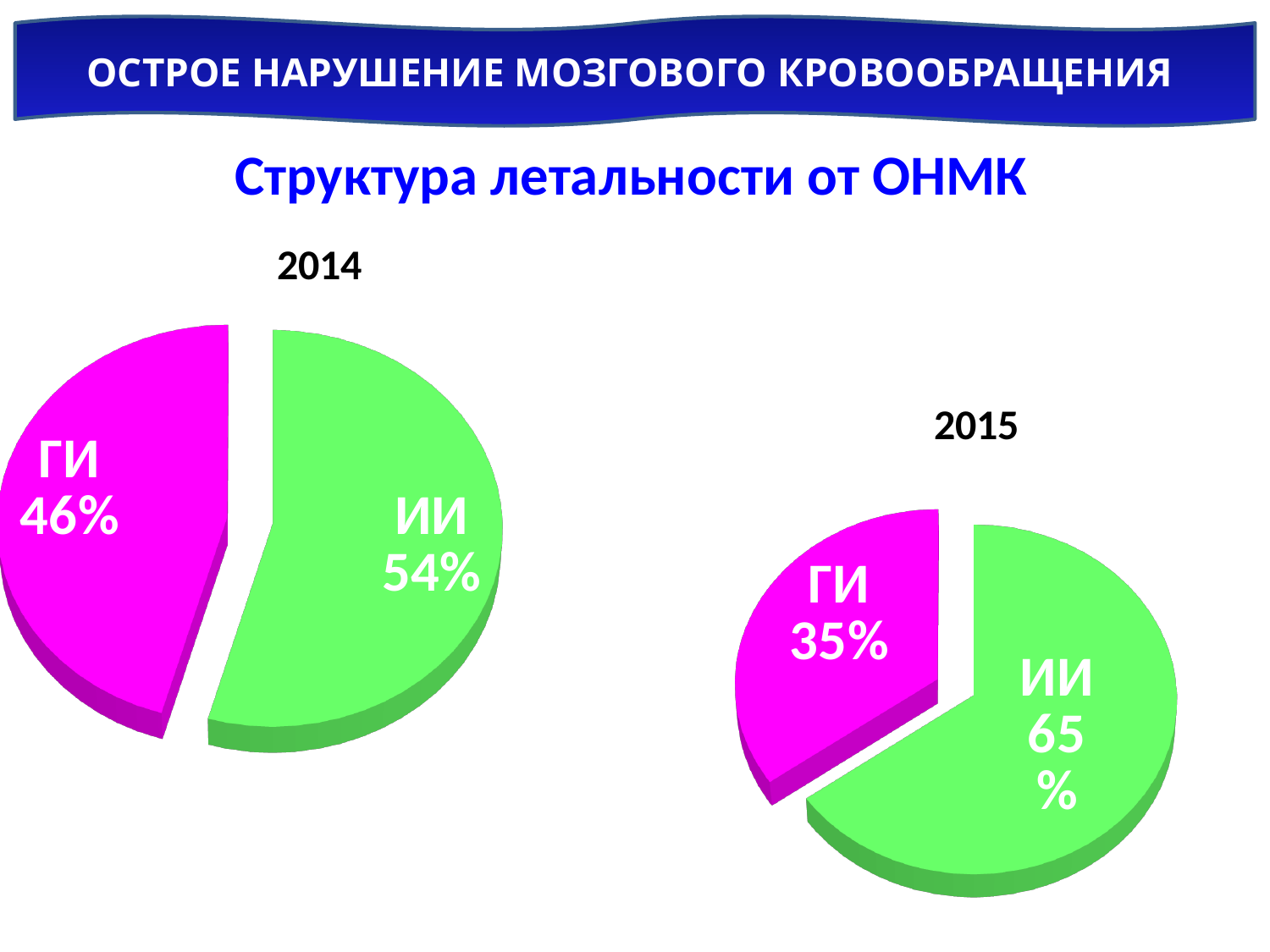
In the 2015 pie chart, which slice is the smallest? ГИ In the 2014 pie chart, what is the difference in percentage points between ИИ and ГИ? 8 Which is larger: the ГИ share in 2014 or the ГИ share in 2015? 2014 In the 2014 pie chart, what share is labelled for ГИ? 46% In the 2015 pie chart, what share is labelled for ИИ? 65% How many slices does the 2015 pie chart have? 2 In the 2014 pie chart, which slice is the largest? ИИ In the 2015 pie chart, what is the difference in percentage points between ИИ and ГИ? 30 What type of chart is used for the 2014 data? Pie chart In the 2014 pie chart, what share is labelled for ИИ? 54% In the 2015 pie chart, what share is labelled for ГИ? 35% What colour is the ГИ slice in the 2014 pie chart? Magenta